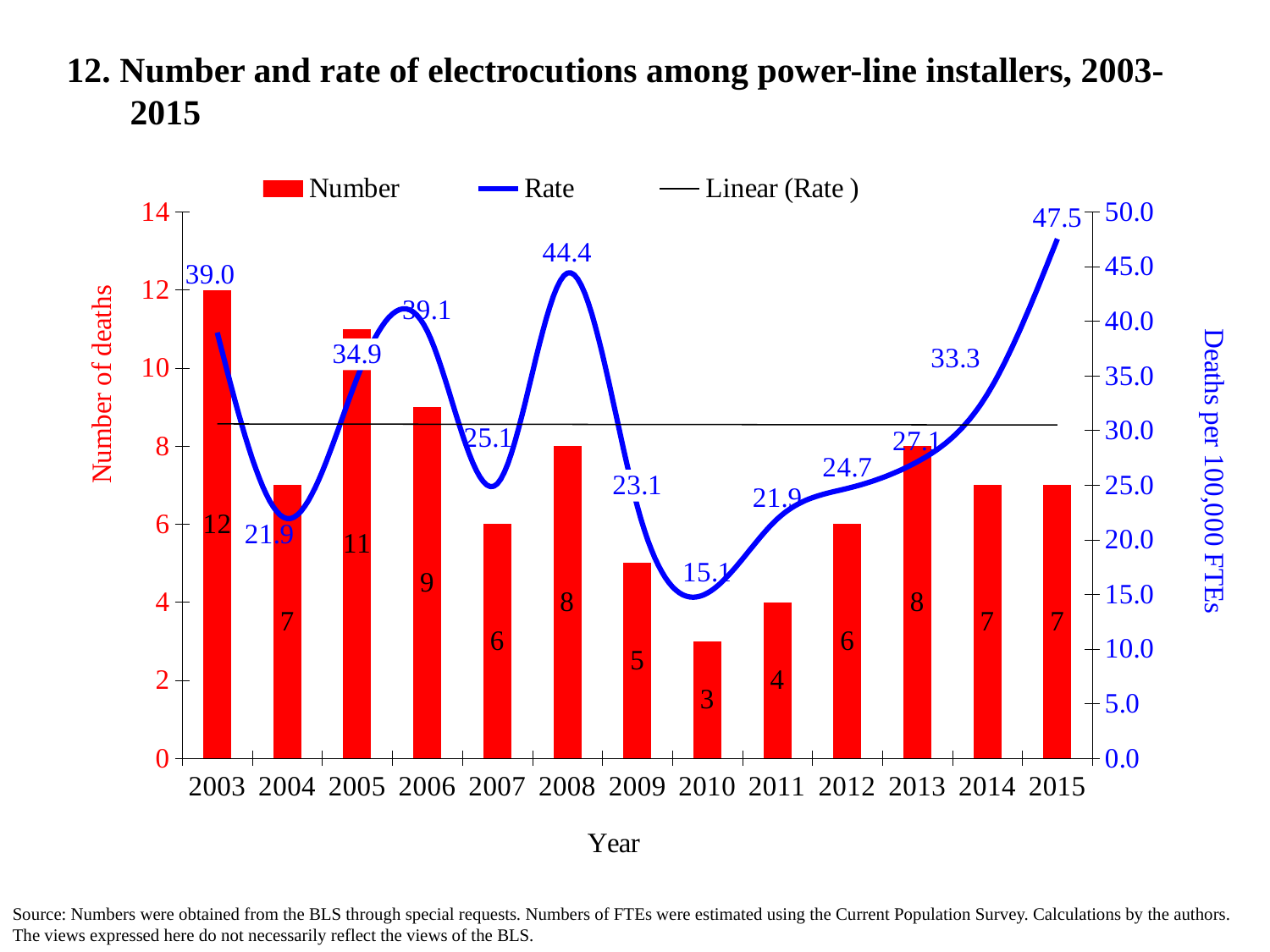
What is the rate value labelled for 2015? 47.5 What is the label of the right-hand vertical axis? Deaths per 100,000 FTEs How many years are shown on the x axis? 13 Which year has the lowest number of deaths? 2010 What is the rate of electrocutions (deaths per 100,000 FTEs) for 2008? 44.4 Which year has the highest number of deaths? 2003 Which year has a higher rate, 2006 or 2013? 2006 How many deaths are shown for 2003? 12 What is the difference in number of deaths between 2005 and 2010? 8 How many series does the legend list? 3 Which year has the lowest rate? 2010 What kind of chart is used to show the Number series? Bar chart